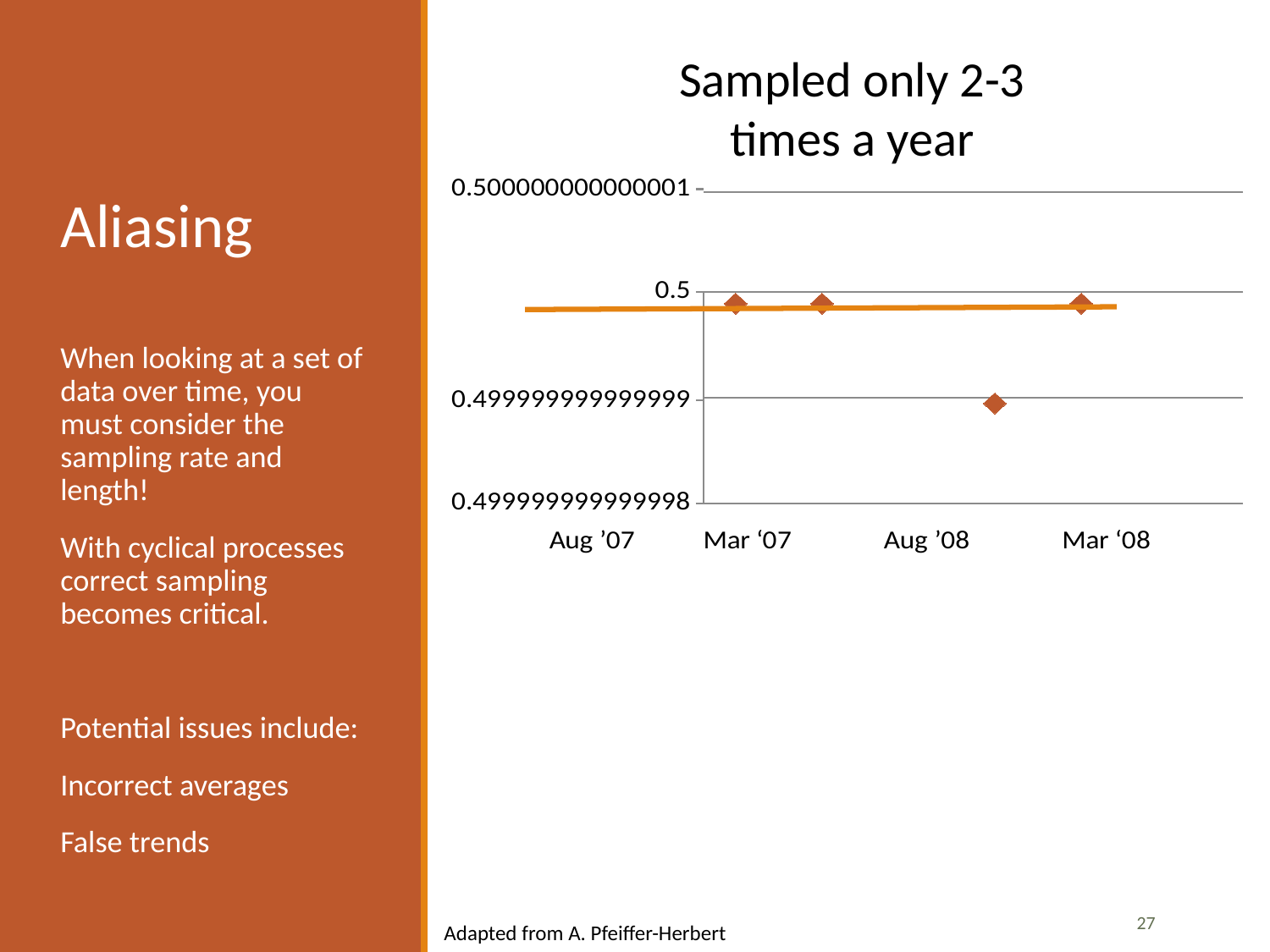
What is the title of the chart? Sampled only 2-3 times a year What is the highest value shown on the y axis of the chart? 0.500000000000001 How many data points are plotted on the chart? 4 What is the first label on the x axis of the chart? Aug '07 Is the first plotted point higher or lower than the third plotted point? higher How many tick values are labelled on the y axis of the chart? 4 Is the value of the third plotted point (from the left) greater or less than 0.499999999999998? greater What kind of chart is shown on the slide? scatter chart What is the lowest value shown on the y axis of the chart? 0.499999999999998 Is the value of the third plotted point (from the left) greater or less than 0.5? less How many labels are shown along the x axis of the chart? 4 Which plotted point has the lowest value: the first, second, third or fourth from the left? the third